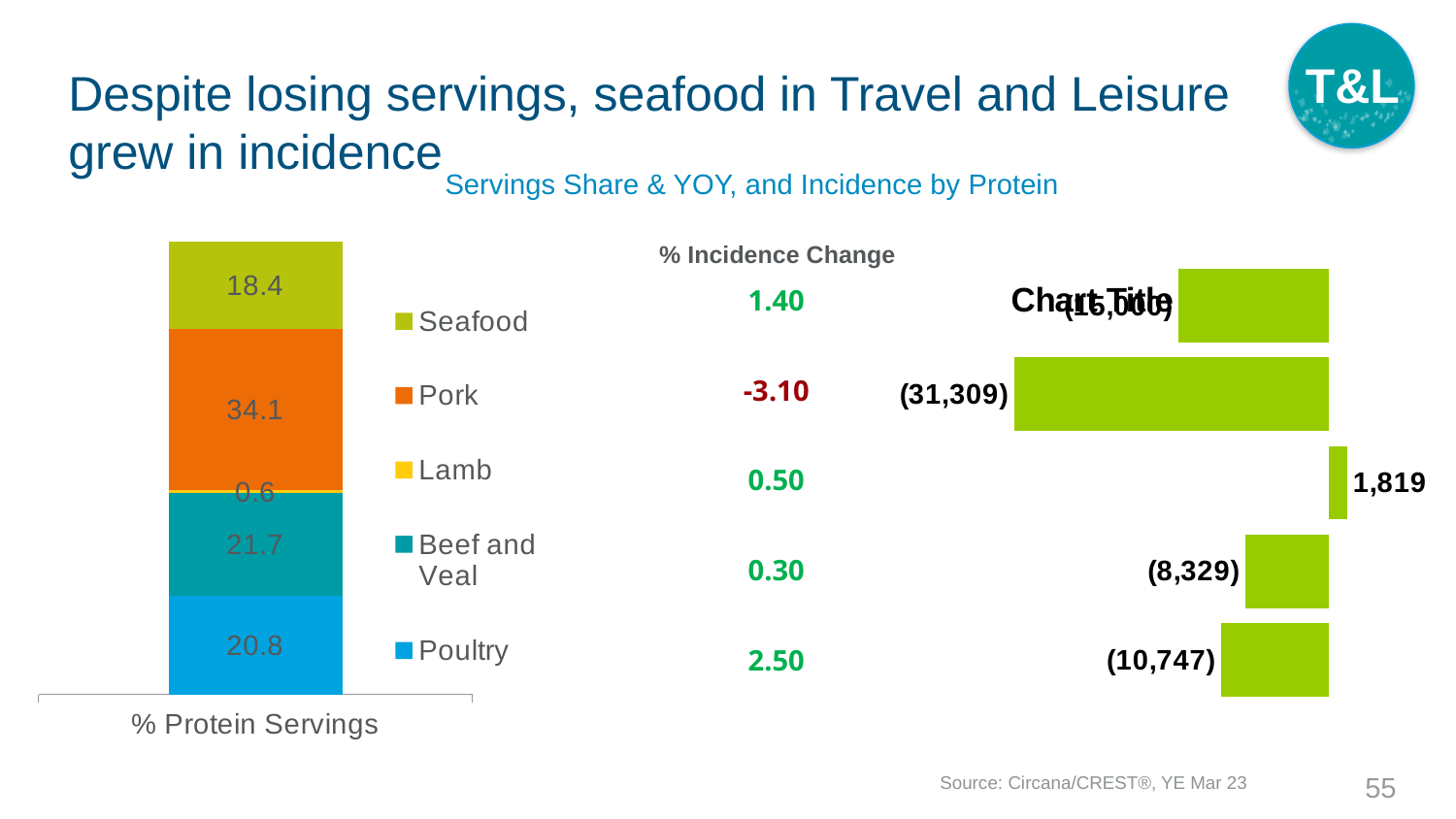
How many entries does the legend of the % Protein Servings chart list? 5 In the % Protein Servings stacked bar chart, what is the value for Pork? 34.1 In the bar chart on the right titled "Chart Title", what is the value of the bottom bar? (10,747) In the bar chart on the right titled "Chart Title", what is the value of the only bar that extends to the right of the axis? 1,819 In the % Protein Servings stacked bar chart, which protein has the largest segment? Pork In the bar chart on the right titled "Chart Title", what is the value of the second bar from the top? (31,309) In the % Protein Servings stacked bar chart, what is the difference between the Beef and Veal value and the Poultry value? 0.9 What kind of chart is the % Protein Servings chart on the left? Stacked bar chart In the % Protein Servings stacked bar chart, what is the total of all five segments? 95.6 In the % Protein Servings stacked bar chart, what is the value for Seafood? 18.4 In the % Protein Servings stacked bar chart, which is larger, the Seafood value or the Poultry value? Poultry In the % Protein Servings stacked bar chart, which protein has the smallest segment? Lamb